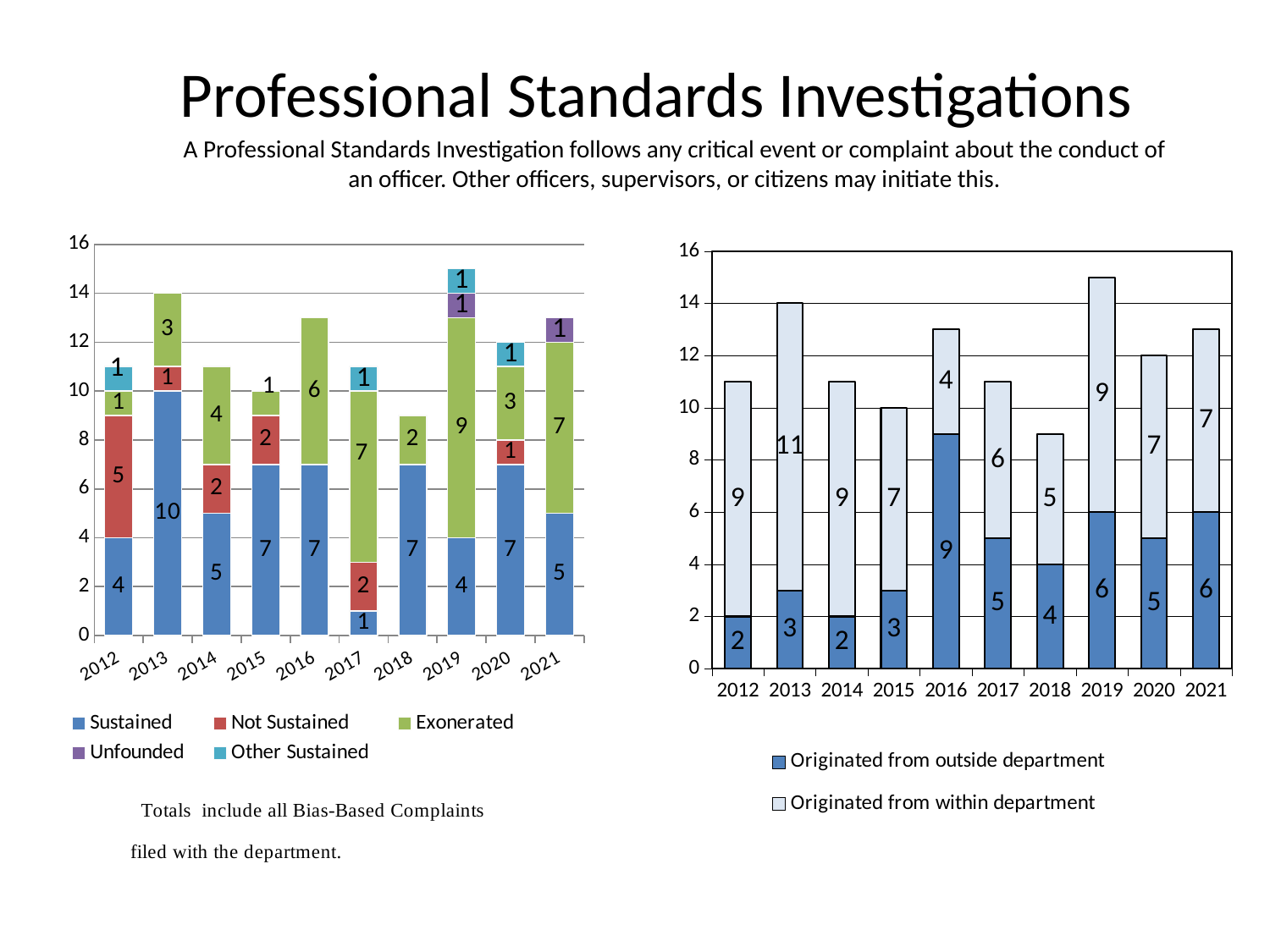
In the left chart, what is the Exonerated value for 2019? 9 In the right chart, what is the value for Originated from within department in 2013? 11 In the right chart, what is the value for Originated from outside department in 2016? 9 In the right chart, what is the total of the stacked bar for 2018? 9 In the right chart, which year has the lowest value for Originated from within department? 2016 In the right chart, what is the difference between Originated from within department and Originated from outside department in 2012? 7 In the left chart, what is the Sustained value for 2013? 10 In the left chart, what is the total of the stacked bar for 2019? 15 What kind of chart is the right chart? Stacked bar chart In the left chart, which year has the highest Sustained value? 2013 In the left chart, what is the Not Sustained value for 2012? 5 In the left chart, how many series does the legend list? 5